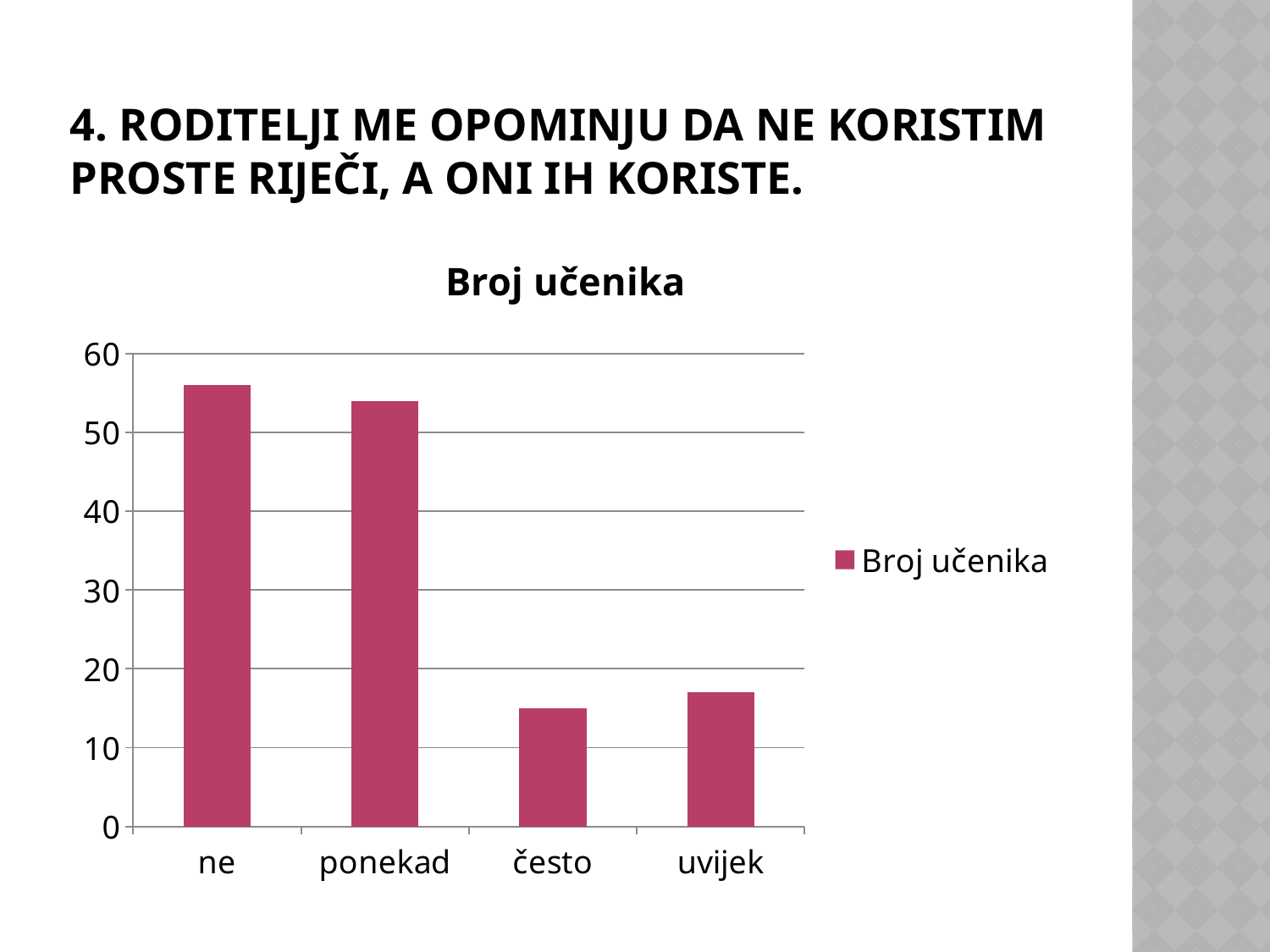
What kind of chart is shown on the slide? bar chart Is the value for "ponekad" greater or less than 50? greater What is the name of the series listed in the legend? Broj učenika Is the value for "često" greater or less than 10? greater Is the value for "ne" greater or less than 50? greater Which has the larger value, "ne" or "često"? ne Which has the larger value, "uvijek" or "ponekad"? ponekad How many categories are shown on the x axis of the chart? 4 How many series does the chart's legend list? 1 What is the title of the chart? Broj učenika